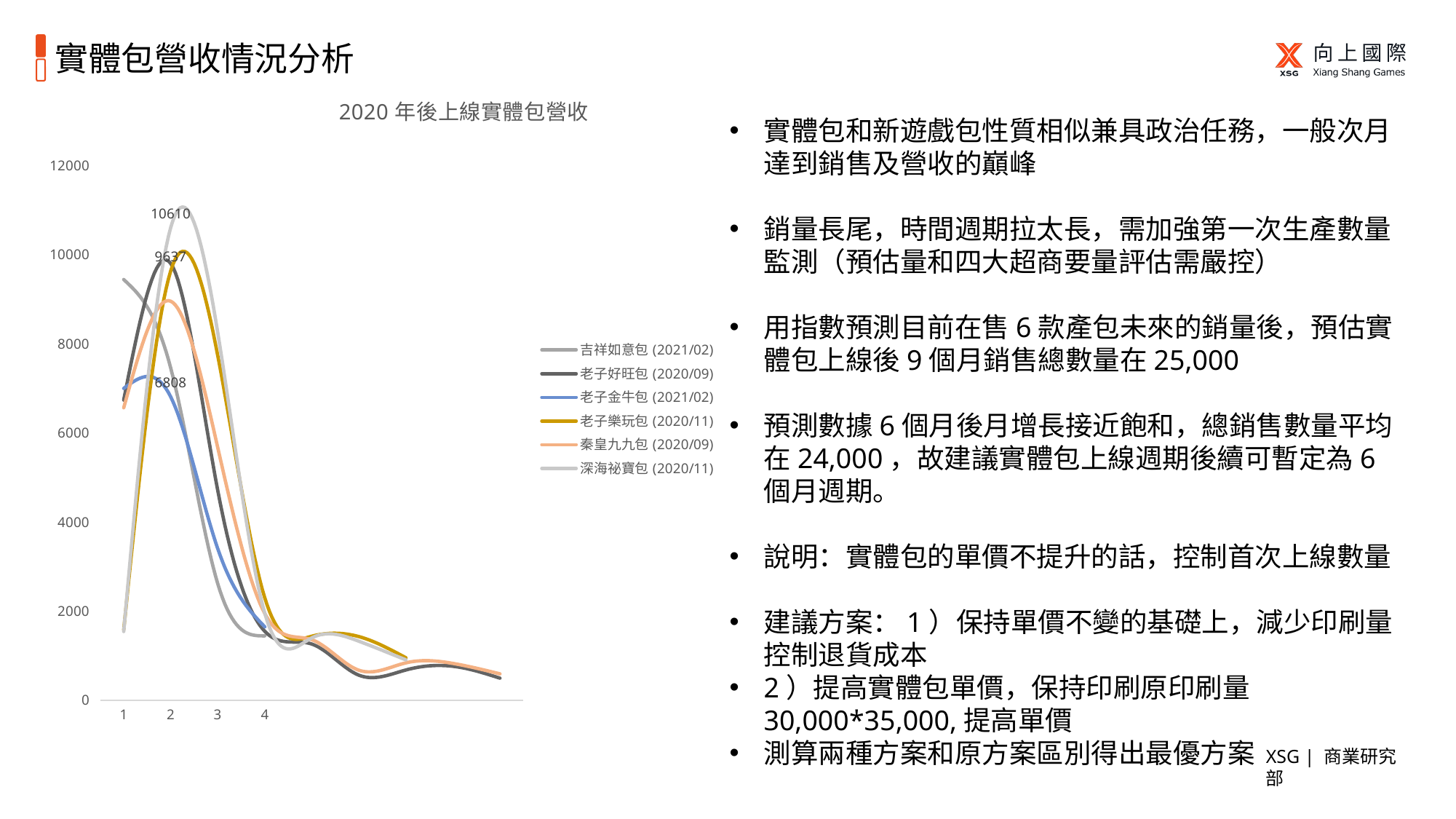
What is the difference between the data labels 9637 and 6808? 2829 What kind of chart is shown on the slide? line chart Is the value for 吉祥如意包 (2021/02) at point 1 greater or less than 8000? greater What is the lowest data label value printed on the chart? 6808 Which series reaches the highest peak on the chart? 深海祕寶包 (2020/11) What is the title of the chart? 2020 年後上線實體包營收 Is the value for 老子金牛包 (2021/02) at point 1 greater or less than 6000? greater After point 2 on the x axis, do the series values generally rise or fall? fall What is the highest data label value printed on the chart? 10610 Which series is listed first in the chart legend? 吉祥如意包 (2021/02) How many series does the chart legend list? 6 What is the difference between the data labels 10610 and 9637? 973